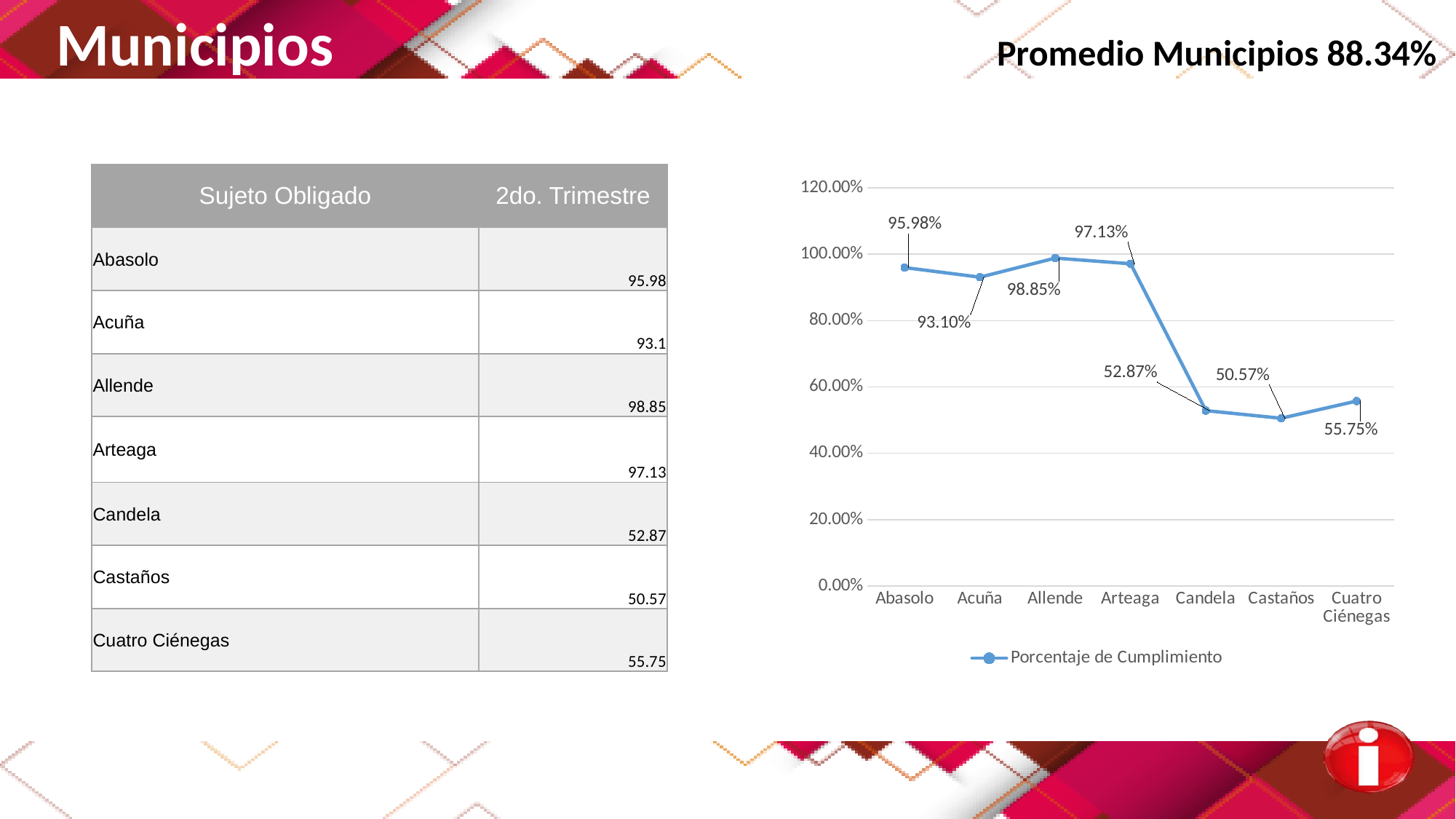
How many series does the chart legend list? 1 What is the value for Candela in the chart? 52.87% Which is larger, the value for Acuña or the value for Allende? Allende What is the value for Abasolo in the chart? 95.98% Is the value for Castaños greater or less than 60.00%? less What is the name of the series shown in the chart legend? Porcentaje de Cumplimiento How many categories are plotted on the x axis of the chart? 7 Which category has the highest value in the chart? Allende What is the value for Cuatro Ciénegas in the chart? 55.75% What kind of chart is shown on the slide? line chart What is the difference between the values for Arteaga and Candela? 44.26% Which category has the lowest value in the chart? Castaños